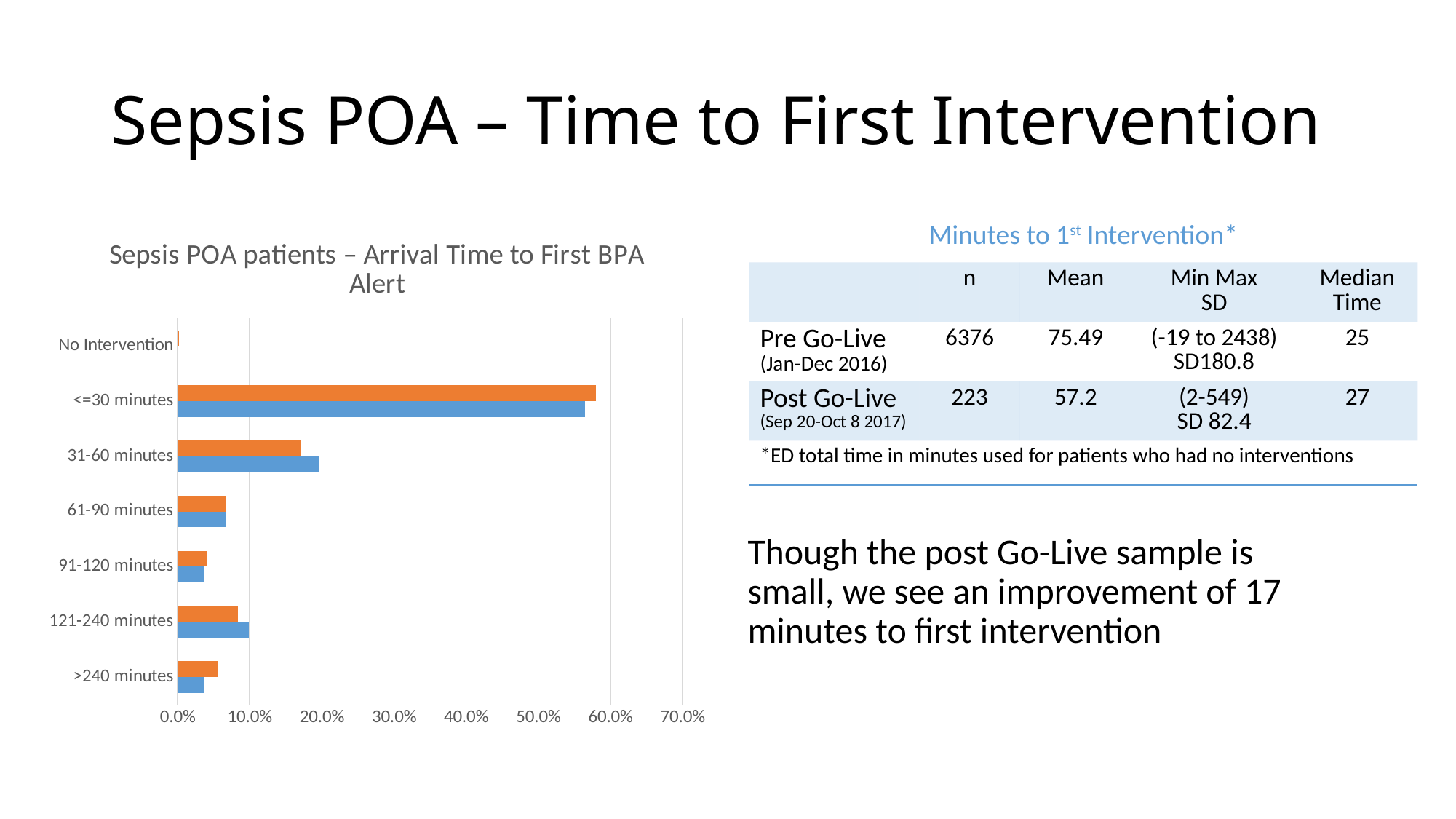
For >240 minutes, which bar is longer, the orange or the blue? orange What is the title of the chart? Sepsis POA patients – Arrival Time to First BPA Alert For 121-240 minutes, which bar is longer, the orange or the blue? blue Which category has the lowest values on the chart? No Intervention For 31-60 minutes, which bar is longer, the orange or the blue? blue Is the orange bar for No Intervention greater or less than 10.0%? less Is the orange bar for <=30 minutes greater or less than 50.0%? greater Is the orange bar for 121-240 minutes greater or less than 10.0%? less Which category has the highest values on the chart? <=30 minutes How many time categories are shown on the chart's vertical axis? 7 What kind of chart is shown on the slide? bar chart